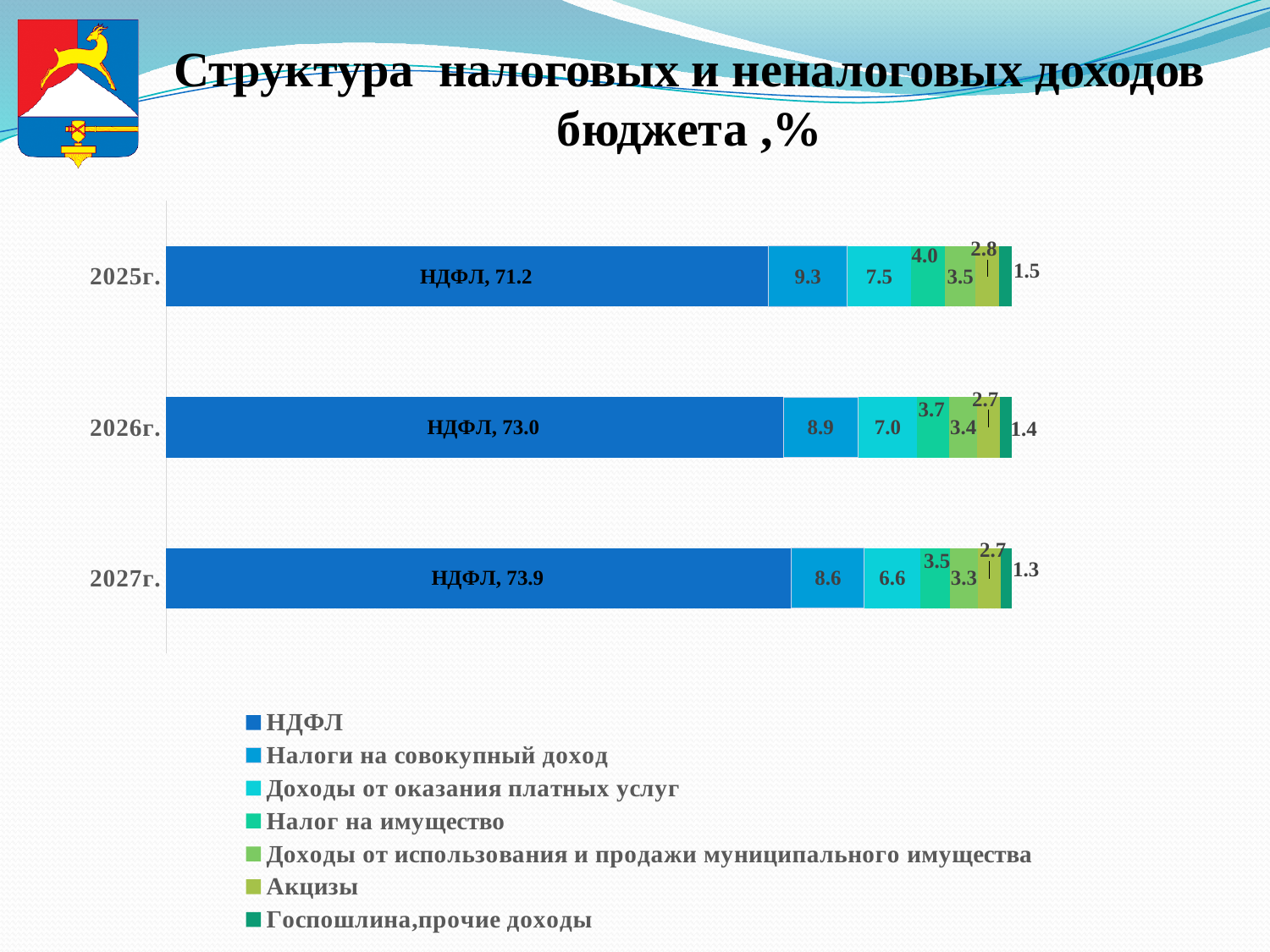
What is the difference between the НДФЛ values for 2027г. and 2025г.? 2.7 How many years are shown on the chart? 3 What is the value of Налоги на совокупный доход for 2027г.? 8.6 What is the value of Доходы от оказания платных услуг for 2026г.? 7.0 What kind of chart is shown on the slide? Stacked bar chart What is the value of Налог на имущество for 2027г.? 3.5 Which is larger: Доходы от оказания платных услуг for 2025г. or for 2027г.? 2025г. Which year has the lowest value for Налоги на совокупный доход? 2027г. How many series does the legend list? 7 What is the value of НДФЛ for 2025г.? 71.2 Which year has the highest value for НДФЛ? 2027г. What is the value of Госпошлина,прочие доходы for 2025г.? 1.5